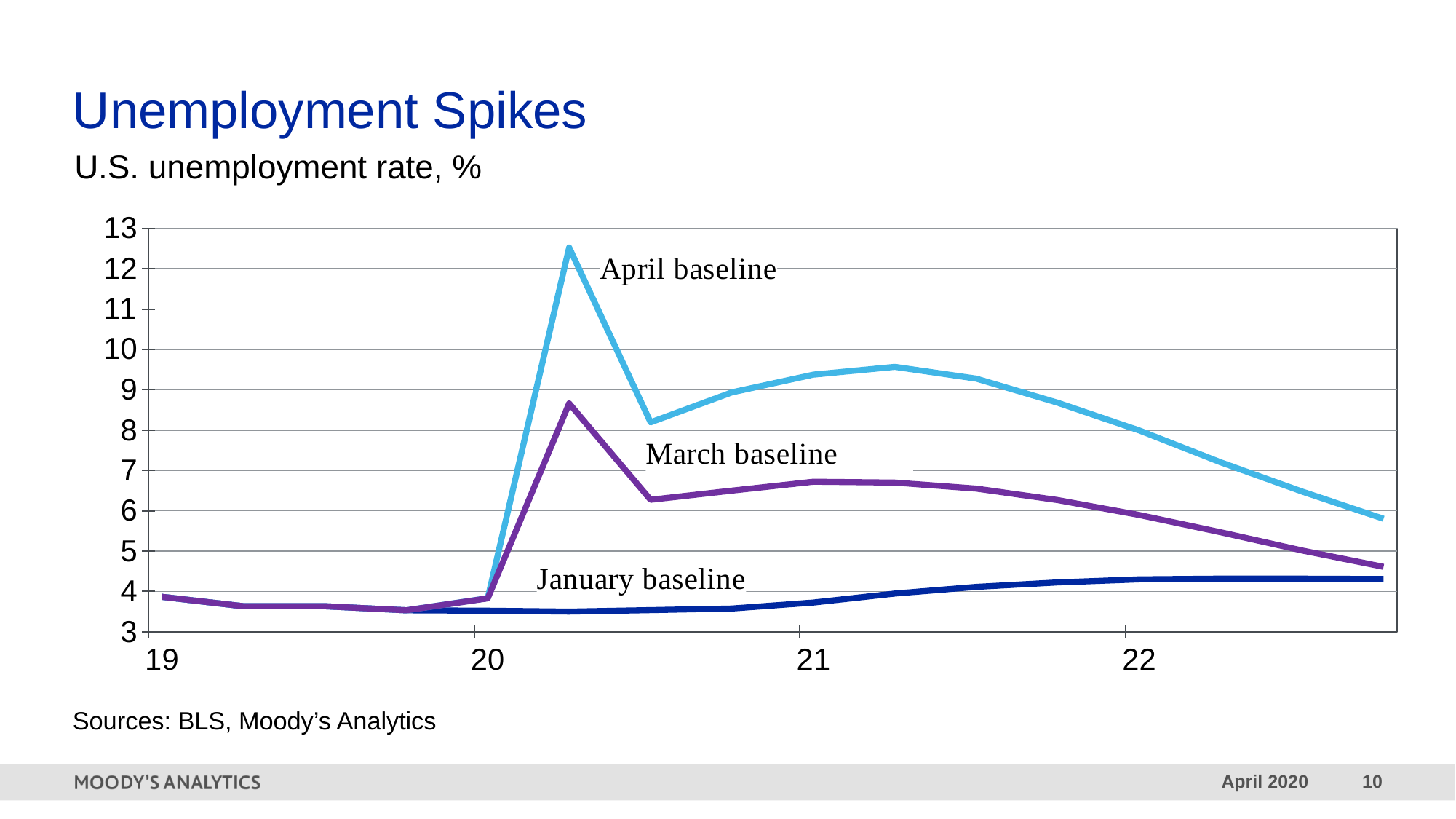
What is the title of the slide? Unemployment Spikes What kind of chart is shown on the slide? Line chart What are the sources listed for the chart? BLS, Moody's Analytics How many series (baselines) are plotted on the chart? 3 Which series stays lowest across the whole chart? January baseline After its 2020 peak, does the April baseline end higher or lower by the end of the chart? Lower Is the value of the January baseline at the end of the chart greater or less than 5? less Is the peak value of the April baseline greater or less than 12? greater Is the peak value of the March baseline greater or less than 8? greater Which series reaches the highest unemployment rate on the chart? April baseline At the 2020 spike, which is higher: the April baseline or the March baseline? April baseline